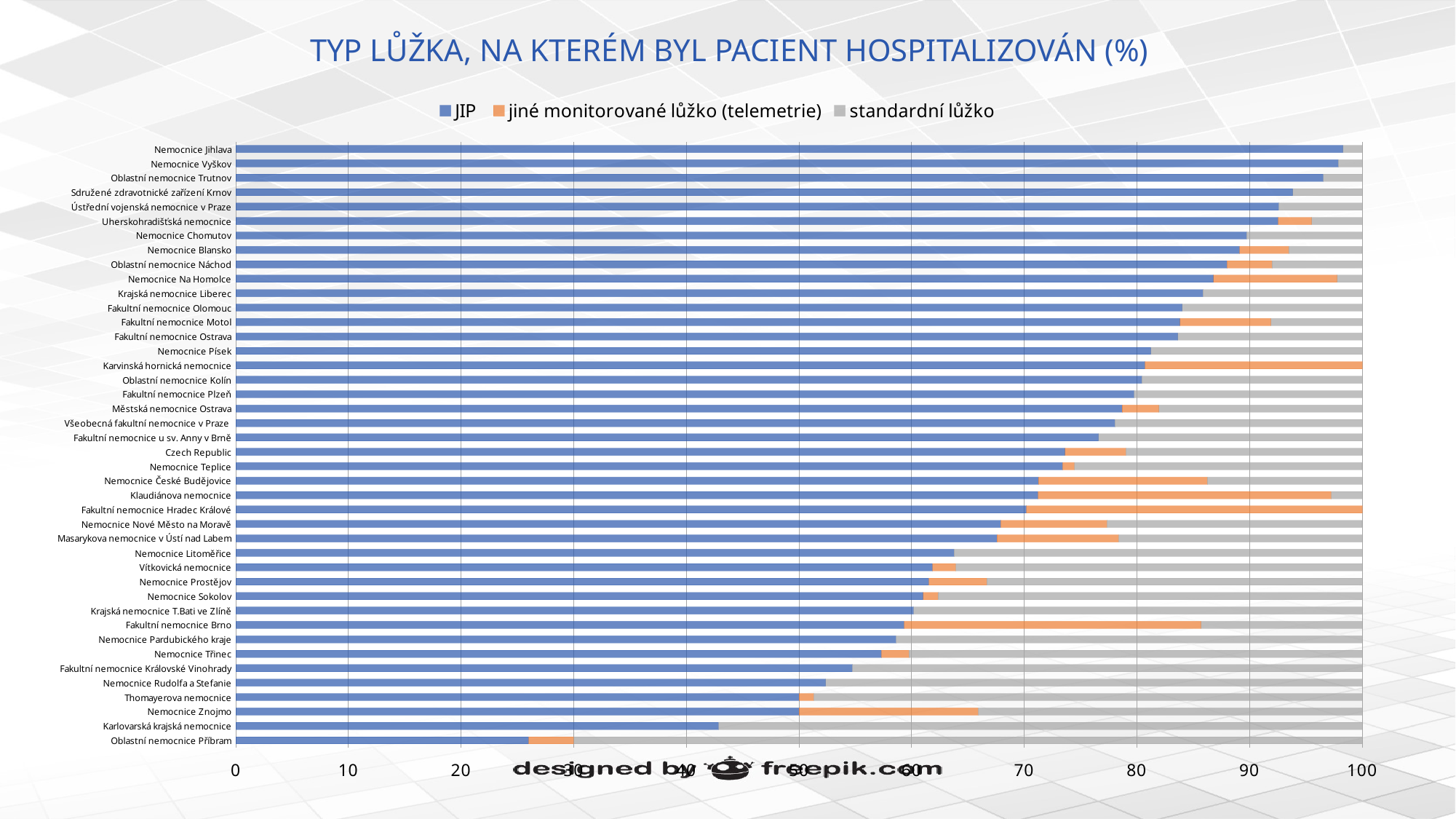
Which hospital has the largest standardní lůžko share? Oblastní nemocnice Příbram Which hospital has the lowest JIP share? Oblastní nemocnice Příbram Is the JIP value for Fakultní nemocnice Motol greater or less than 80? greater What is the title of the chart? TYP LŮŽKA, NA KTERÉM BYL PACIENT HOSPITALIZOVÁN (%) Is the JIP value for Nemocnice Jihlava greater or less than 90? greater How many series does the legend list? 3 What kind of chart is shown on the slide? Stacked bar chart Do the JIP values rise or fall going from the top of the chart to the bottom? fall How many hospitals (categories) are plotted on the chart? 42 Which has a larger jiné monitorované lůžko (telemetrie) share, Fakultní nemocnice Brno or Nemocnice Třinec? Fakultní nemocnice Brno Which hospital has the highest JIP share? Nemocnice Jihlava Is the JIP value for Karlovarská krajská nemocnice greater or less than 50? less